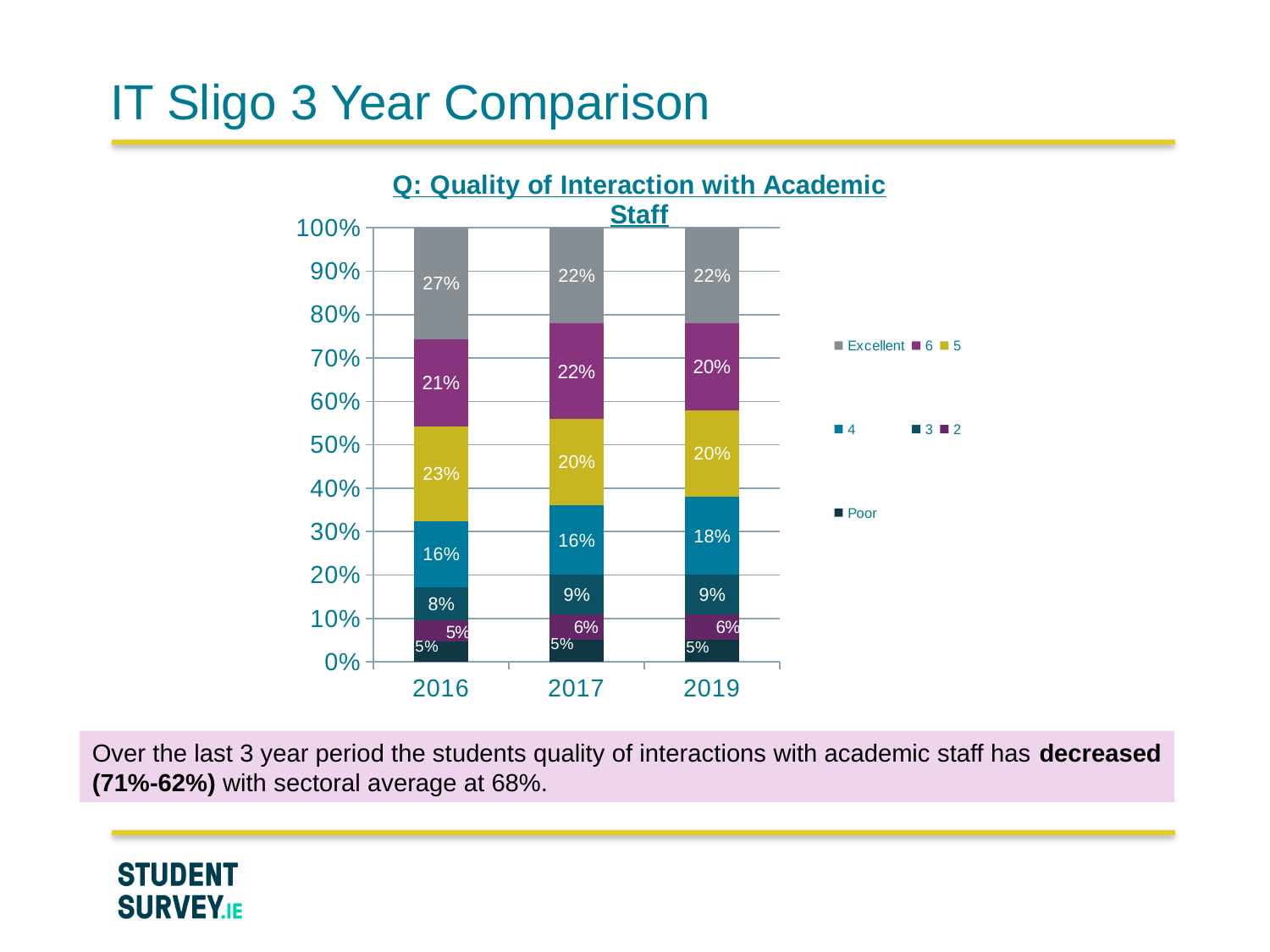
What is the value for series 3 in 2016? 8% What is the value for series 5 in 2019? 20% How many years are shown on the x axis? 3 What is the value for series 4 in 2017? 16% Which year has the lowest value for series 4? 2016 and 2017 (tied at 16%) Is the value for series 6 larger in 2017 or in 2019? 2017 What kind of chart is shown on the slide? Stacked bar chart How many series does the legend list? 7 What is the Excellent value for 2016? 27% What is the difference between the Excellent value in 2016 and in 2019? 5% What is the title of the chart? Q: Quality of Interaction with Academic Staff Which year has the highest Excellent value? 2016